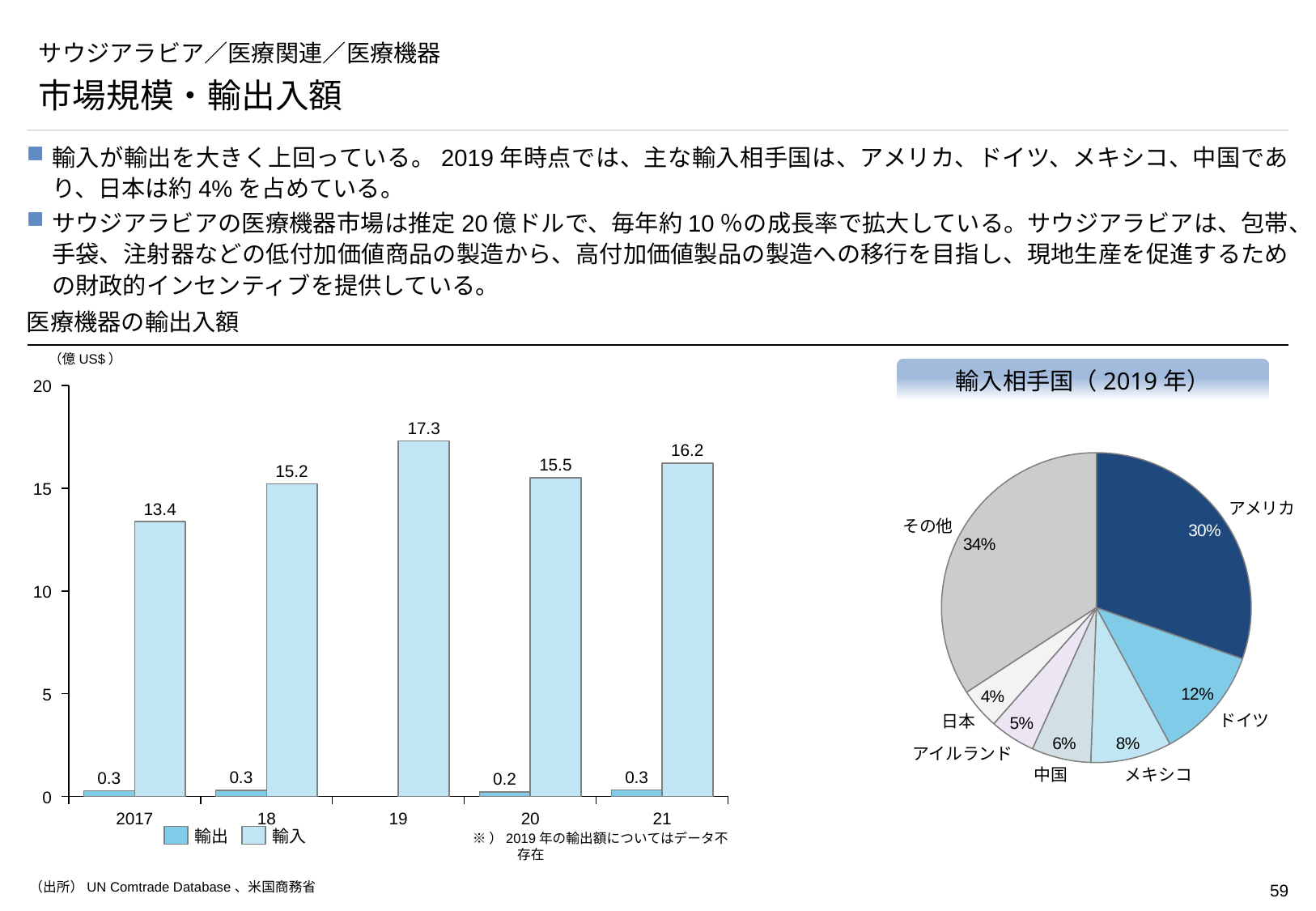
In the bar chart 医療機器の輸出入額, what is the 輸入 value for 19? 17.3 In the bar chart 医療機器の輸出入額, how many series does the legend list? 2 In the pie chart 輸入相手国（2019年）, which is larger, ドイツ or メキシコ? ドイツ In the pie chart 輸入相手国（2019年）, what share does 日本 have? 4% In the bar chart 医療機器の輸出入額, which year has the highest 輸入 value? 19 In the pie chart 輸入相手国（2019年）, what share does アメリカ have? 30% In the bar chart 医療機器の輸出入額, which year has the lowest 輸入 value? 2017 In the bar chart 医療機器の輸出入額, what is the 輸出 value for 20? 0.2 In the bar chart 医療機器の輸出入額, what is the 輸入 value for 2017? 13.4 In the pie chart 輸入相手国（2019年）, how many slices are there? 7 What kind of chart is 医療機器の輸出入額? bar chart In the bar chart 医療機器の輸出入額, what is the difference between the 輸入 values for 19 and 20? 1.8